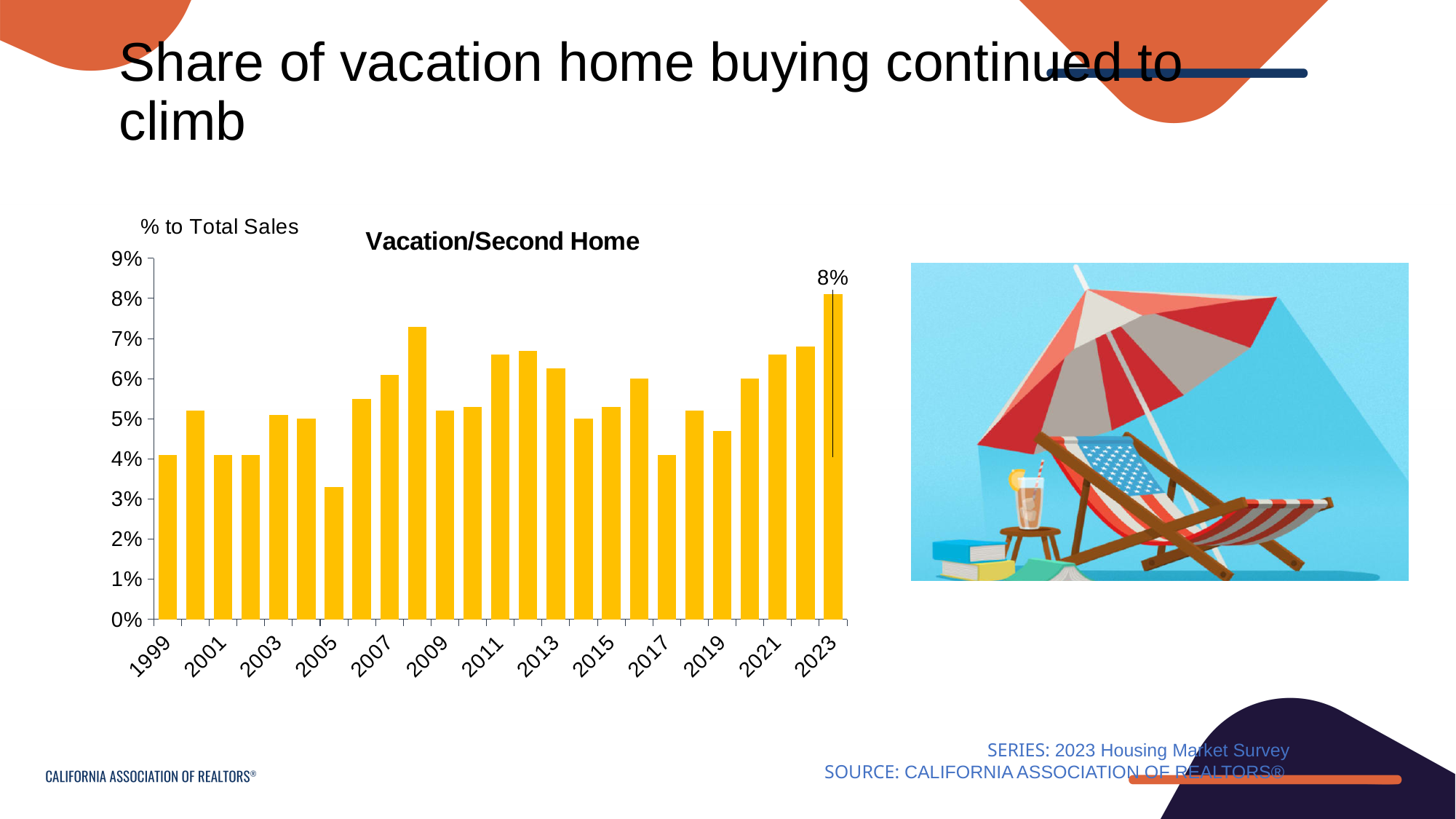
Is the value for 2005 greater or less than 4%? less Is the value for 2008 greater or less than 7%? greater How many years (bars) are plotted in the chart? 25 Is the value for 2017 greater or less than 5%? less Which year has the lowest share of vacation/second home buying? 2005 Which year has a larger share, 1999 or 2005? 1999 Which year has the highest share of vacation/second home buying? 2023 What is the value shown for 2023 in the Vacation/Second Home chart? 8% What is the title of the chart? Vacation/Second Home Which year has a larger share, 2008 or 2023? 2023 What kind of chart is shown on the slide? Bar chart